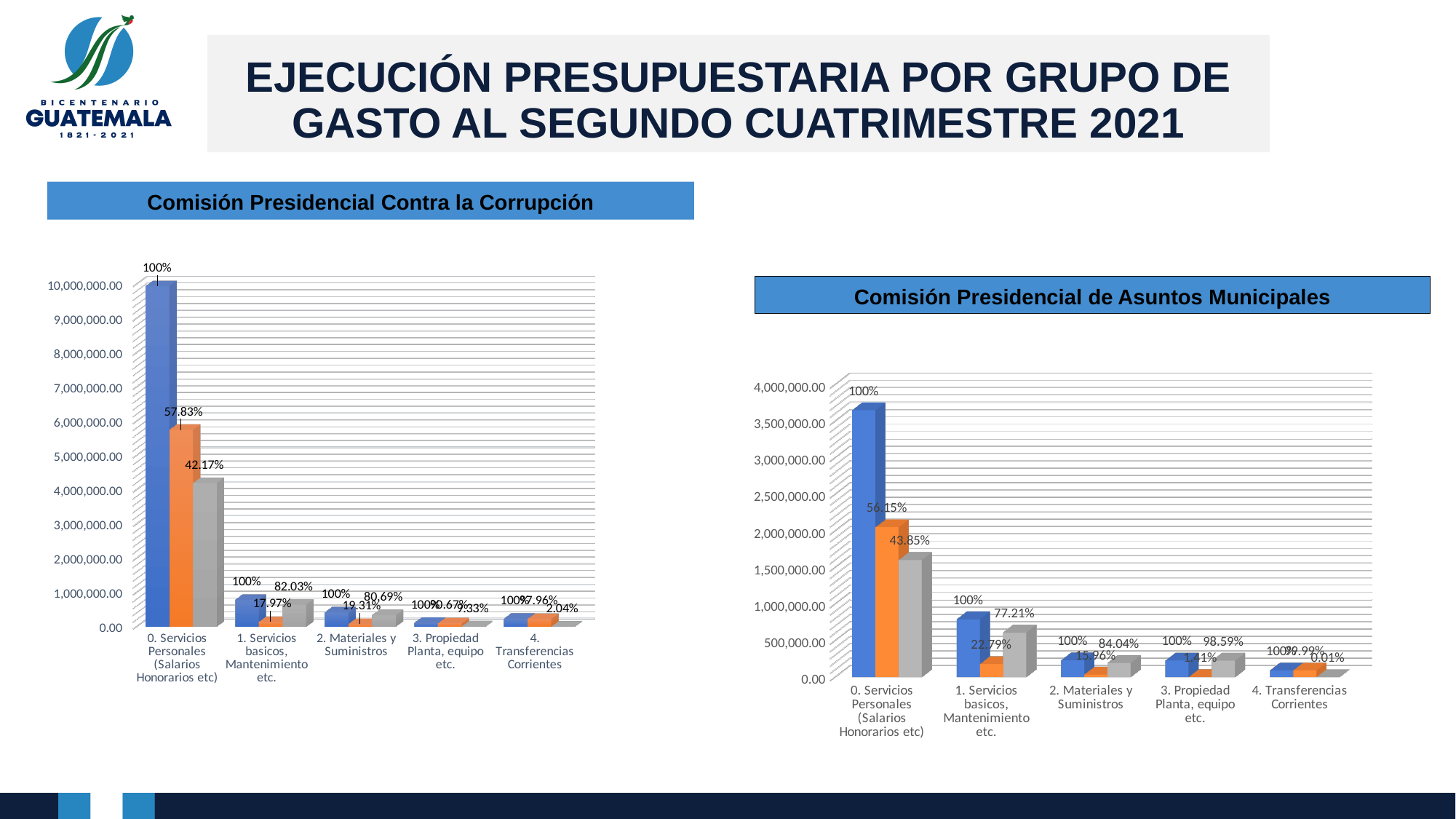
In the Comisión Presidencial Contra la Corrupción chart, what percentage is labelled on the orange bar for '0. Servicios Personales (Salarios Honorarios etc)'? 57.83% In the Comisión Presidencial de Asuntos Municipales chart, what percentage is labelled on the orange bar for '0. Servicios Personales (Salarios Honorarios etc)'? 56.15% In the Comisión Presidencial Contra la Corrupción chart, is the orange bar for '0. Servicios Personales (Salarios Honorarios etc)' greater or less than 5,000,000.00? greater In the Comisión Presidencial de Asuntos Municipales chart, what percentage is labelled on the grey bar for '3. Propiedad Planta, equipo etc.'? 98.59% In the Comisión Presidencial de Asuntos Municipales chart, is the blue bar for '0. Servicios Personales (Salarios Honorarios etc)' greater or less than 3,500,000.00? greater In the Comisión Presidencial Contra la Corrupción chart, what percentage is labelled on the grey bar for '1. Servicios basicos, Mantenimiento etc.'? 82.03% How many categories are shown on the x axis of the Comisión Presidencial de Asuntos Municipales chart? 5 In the Comisión Presidencial Contra la Corrupción chart, what percentage is labelled on the grey bar for '4. Transferencias Corrientes'? 2.04% In the Comisión Presidencial de Asuntos Municipales chart, which is larger for '1. Servicios basicos, Mantenimiento etc.': the orange bar or the grey bar? The grey bar What kind of chart is the Comisión Presidencial Contra la Corrupción chart? Bar chart In the Comisión Presidencial de Asuntos Municipales chart, what percentage is labelled on the orange bar for '2. Materiales y Suministros'? 15.96% In the Comisión Presidencial Contra la Corrupción chart, which category has the tallest bar? 0. Servicios Personales (Salarios Honorarios etc)